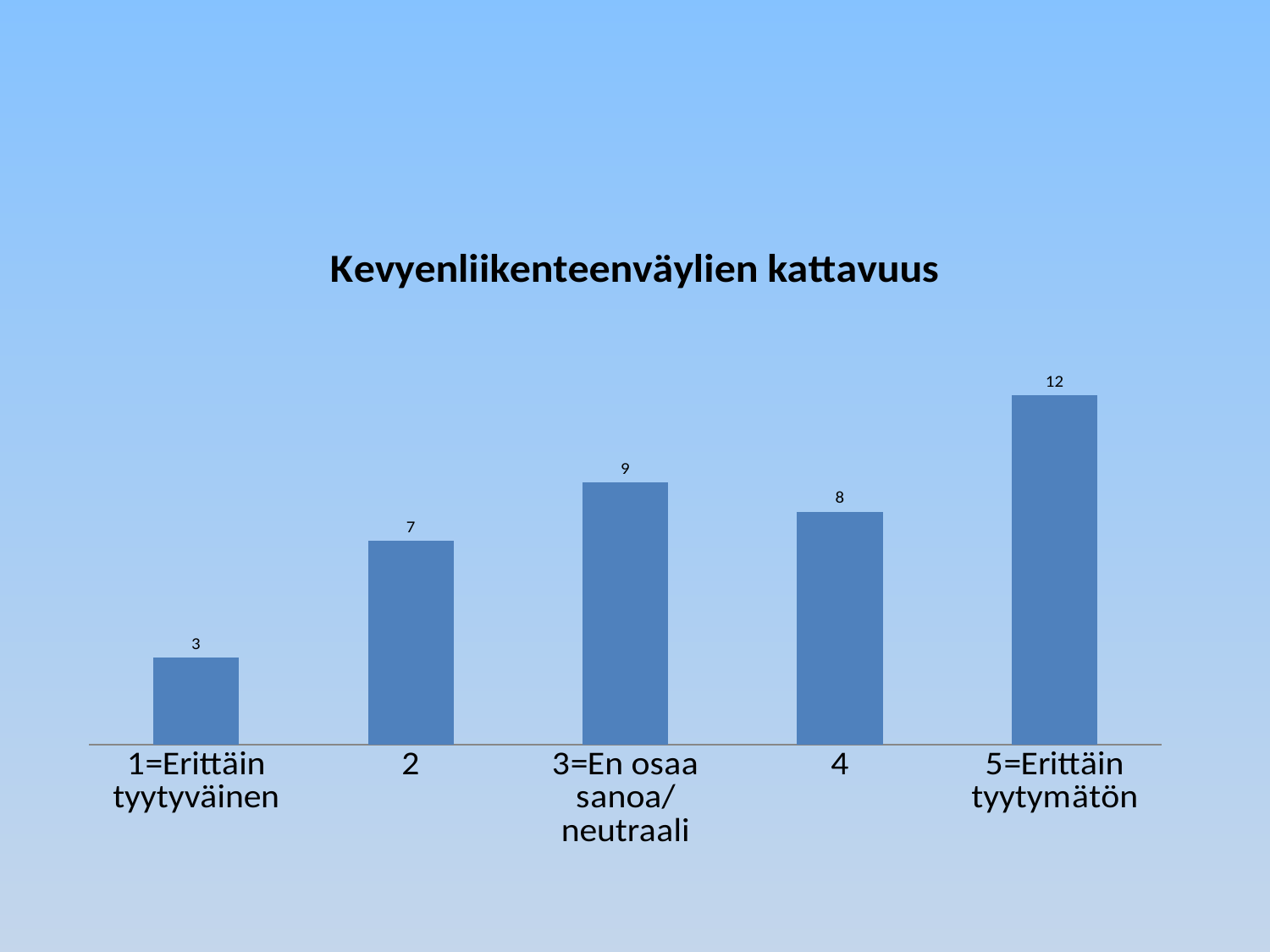
How many categories are shown on the x axis? 5 Which category has the highest value? 5=Erittäin tyytymätön Which category has the lowest value? 1=Erittäin tyytyväinen What is the value for the category "5=Erittäin tyytymätön"? 12 Which is larger, the value for "3=En osaa sanoa/neutraali" or the value for "4"? 3=En osaa sanoa/neutraali What is the title of the chart? Kevyenliikenteenväylien kattavuus What is the value for the category "3=En osaa sanoa/neutraali"? 9 What is the value for category "2"? 7 What is the value for category "4"? 8 What is the value for the category "1=Erittäin tyytyväinen"? 3 What is the difference between the values for "5=Erittäin tyytymätön" and "1=Erittäin tyytyväinen"? 9 What kind of chart is shown on the slide? Bar chart